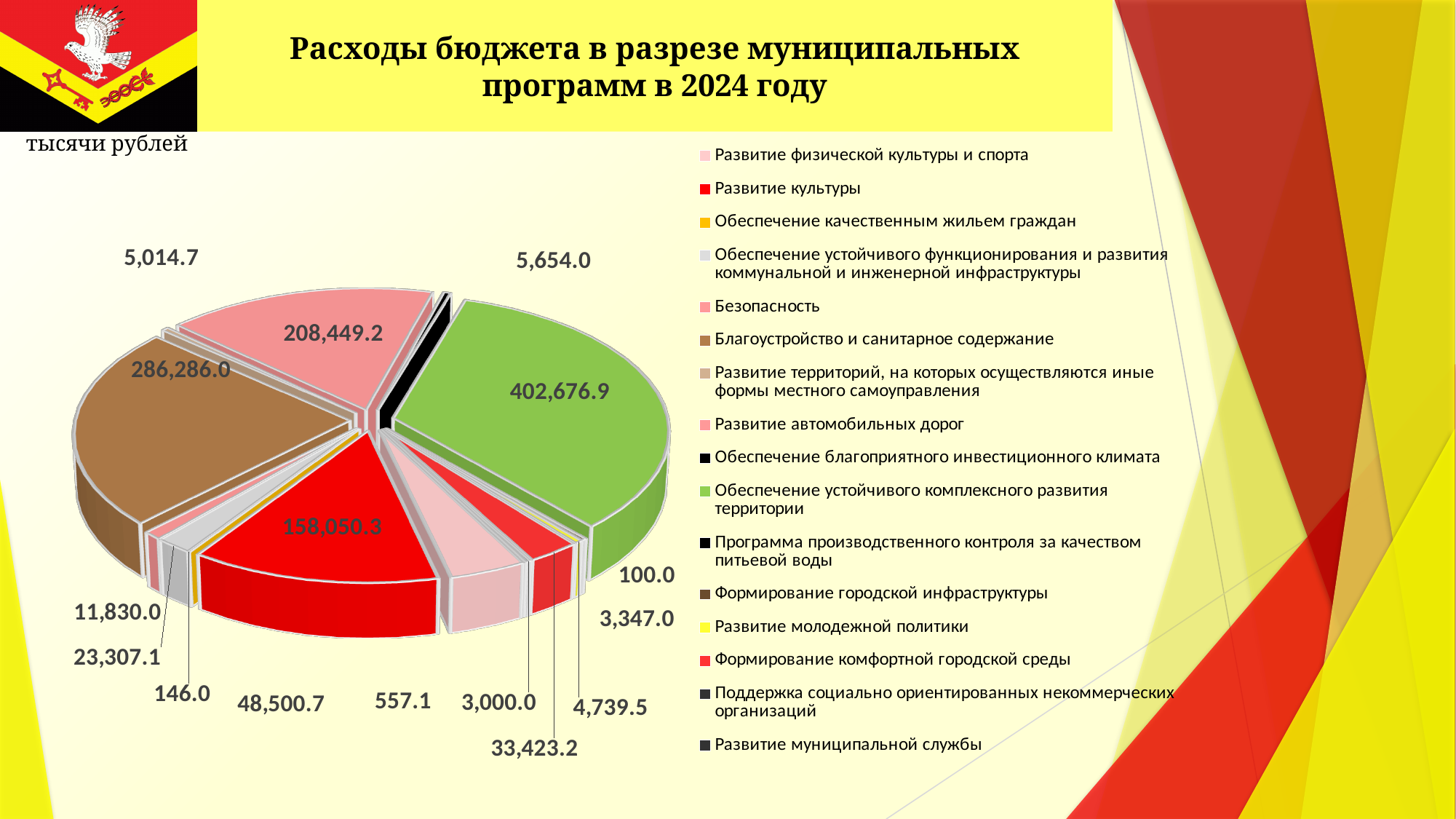
Which is larger: the slice labelled 208,449.2 or the slice labelled 158,050.3? 208,449.2 How many slices (data labels) does the pie chart have? 16 How many entries does the legend list? 16 What is the value for Благоустройство и санитарное содержание (the brown slice)? 286,286.0 What is the difference between the largest slice (402,676.9) and the brown slice (286,286.0)? 116,390.9 In what units are the values on the chart given? тысячи рублей What is the title of the chart? Расходы бюджета в разрезе муниципальных программ в 2024 году Which program has the largest slice of the pie? Обеспечение устойчивого комплексного развития территории What is the value of the largest slice of the pie? 402,676.9 What is the smallest value labelled on the pie chart? 100.0 What type of chart is shown on the slide? pie chart What is the value for Развитие культуры (the large red slice)? 158,050.3